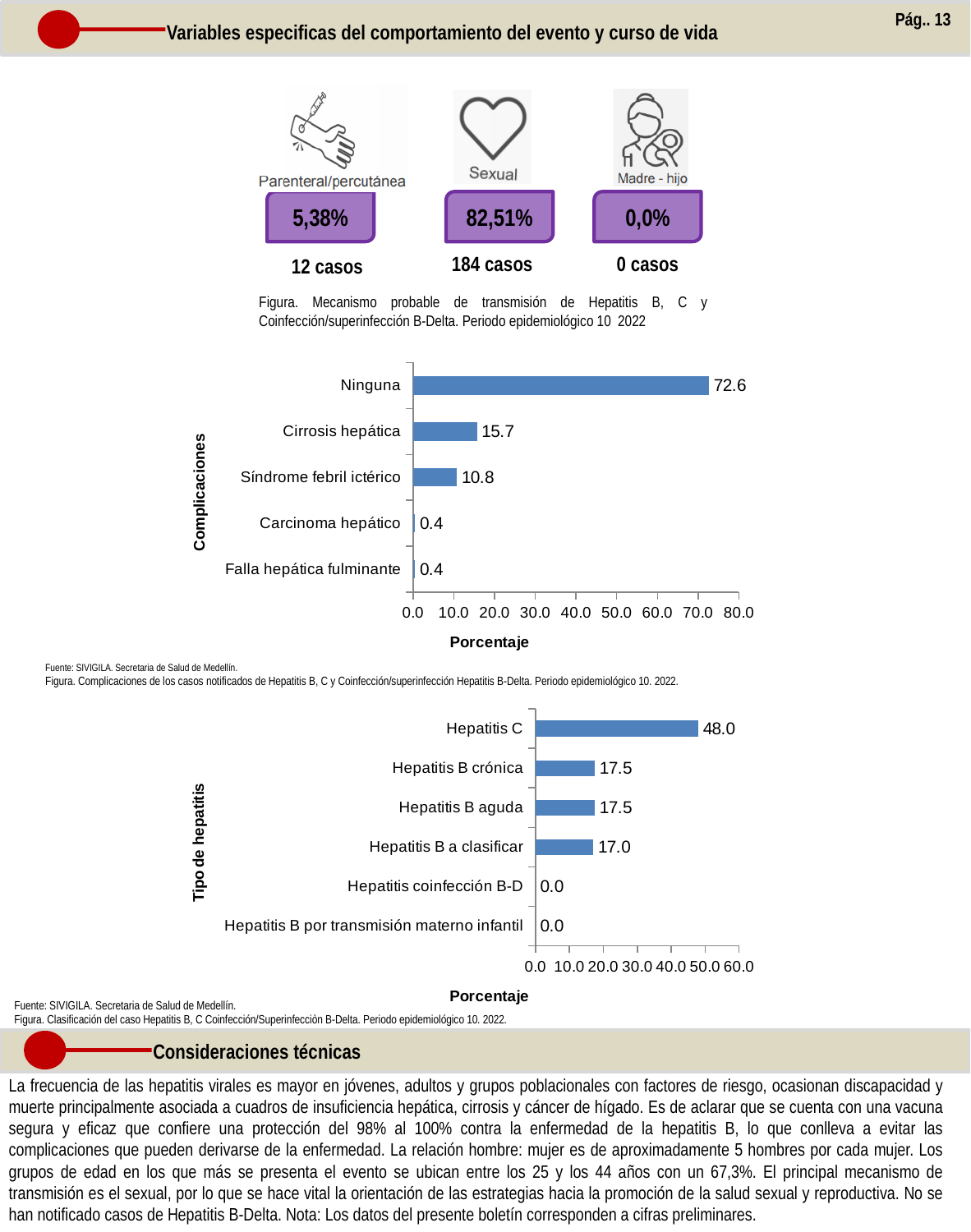
In the lower chart (Tipo de hepatitis), which category has the highest value? Hepatitis C In the upper chart (Complicaciones), how many categories are plotted? 5 In the upper chart (Complicaciones), what is the value for Ninguna? 72.6 In the upper chart (Complicaciones), which category has the highest value? Ninguna In the upper chart (Complicaciones), what is the difference between Cirrosis hepática and Síndrome febril ictérico? 4.9 In the lower chart (Tipo de hepatitis), what is the value for Hepatitis B a clasificar? 17.0 In the upper chart (Complicaciones), what is the label of the x axis? Porcentaje In the lower chart (Tipo de hepatitis), what is the difference between Hepatitis C and Hepatitis B crónica? 30.5 In the upper chart (Complicaciones), what is the value for Cirrosis hepática? 15.7 In the lower chart (Tipo de hepatitis), how many categories are plotted? 6 In the lower chart (Tipo de hepatitis), what is the value for Hepatitis C? 48.0 What kind of chart is the lower chart (Tipo de hepatitis)? Bar chart